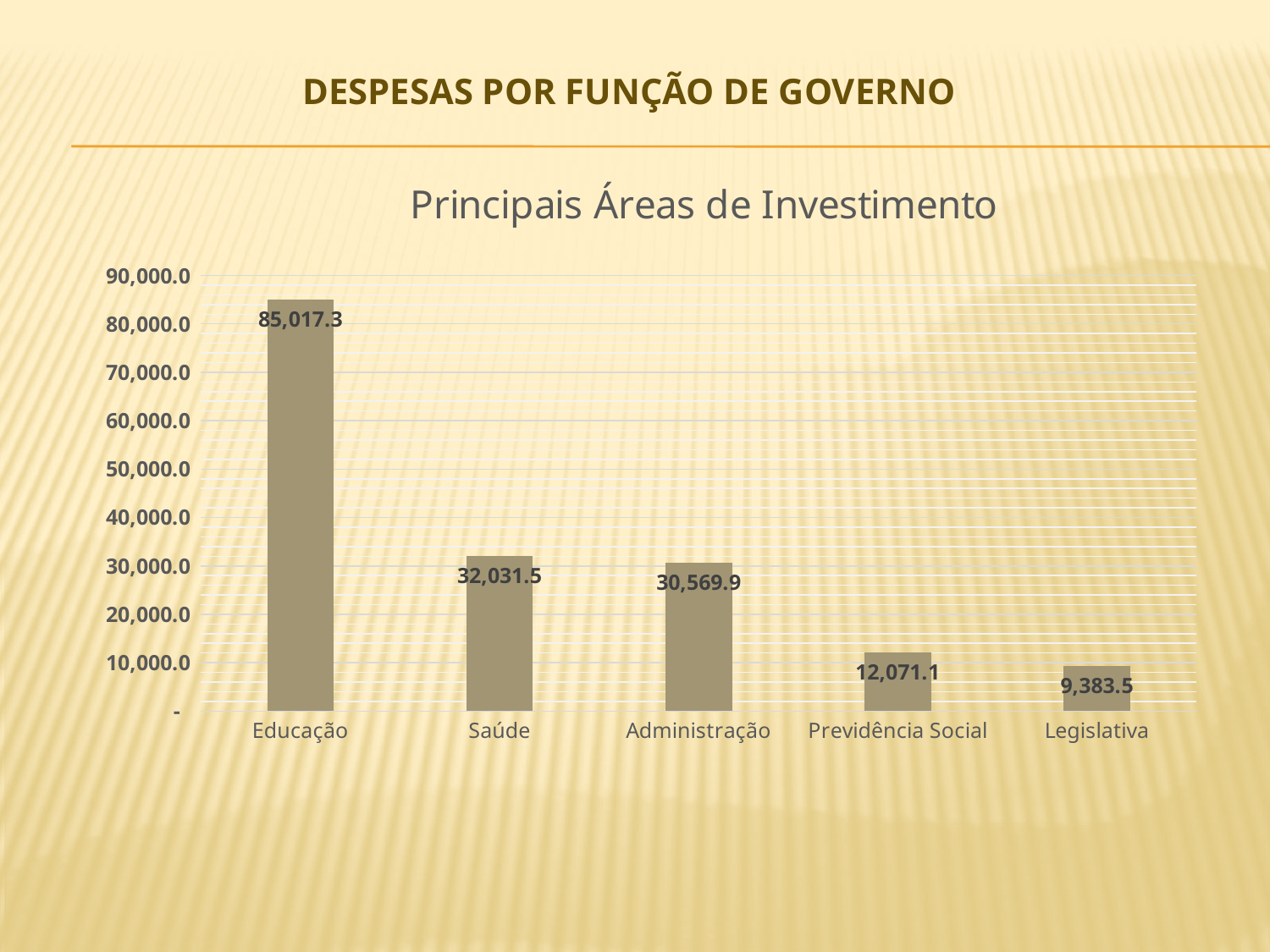
Is the value for Administração greater or less than 40,000.0? less What is the value for Legislativa? 9,383.5 What is the value for Saúde? 32,031.5 What is the value for Educação? 85,017.3 Which is larger, the value for Saúde or the value for Administração? Saúde What is the title of the chart? Principais Áreas de Investimento How many categories are shown in the chart? 5 What is the value for Previdência Social? 12,071.1 Which category has the highest value? Educação What is the difference between the values for Educação and Saúde? 52,985.8 Which category has the lowest value? Legislativa What is the difference between the values for Previdência Social and Legislativa? 2,687.6